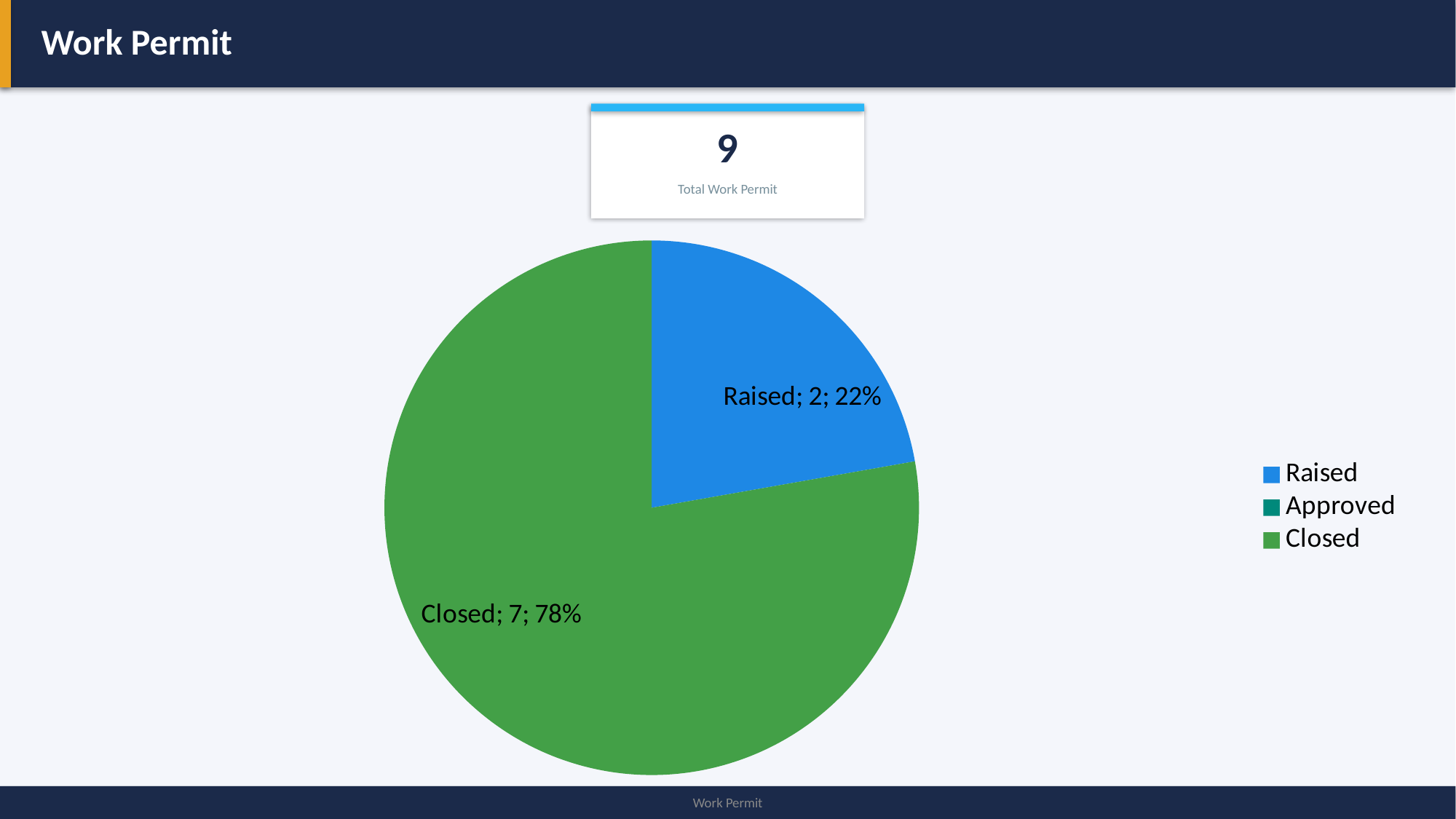
What kind of chart is shown on the slide? pie chart How many work permits are Raised according to the pie chart? 2 What colour is the Closed slice in the pie chart? green Which legend entry has no visible slice in the pie chart? Approved How many work permits are Closed according to the pie chart? 7 What share of the pie does the Raised slice represent? 22% What is the difference between the number of Closed and Raised work permits? 5 What is the total number of work permits shown in the box above the pie chart? 9 How many entries does the legend list? 3 Which category has the largest slice in the pie chart? Closed Which of the two labelled slices is larger, Raised or Closed? Closed What share of the pie does the Closed slice represent? 78%